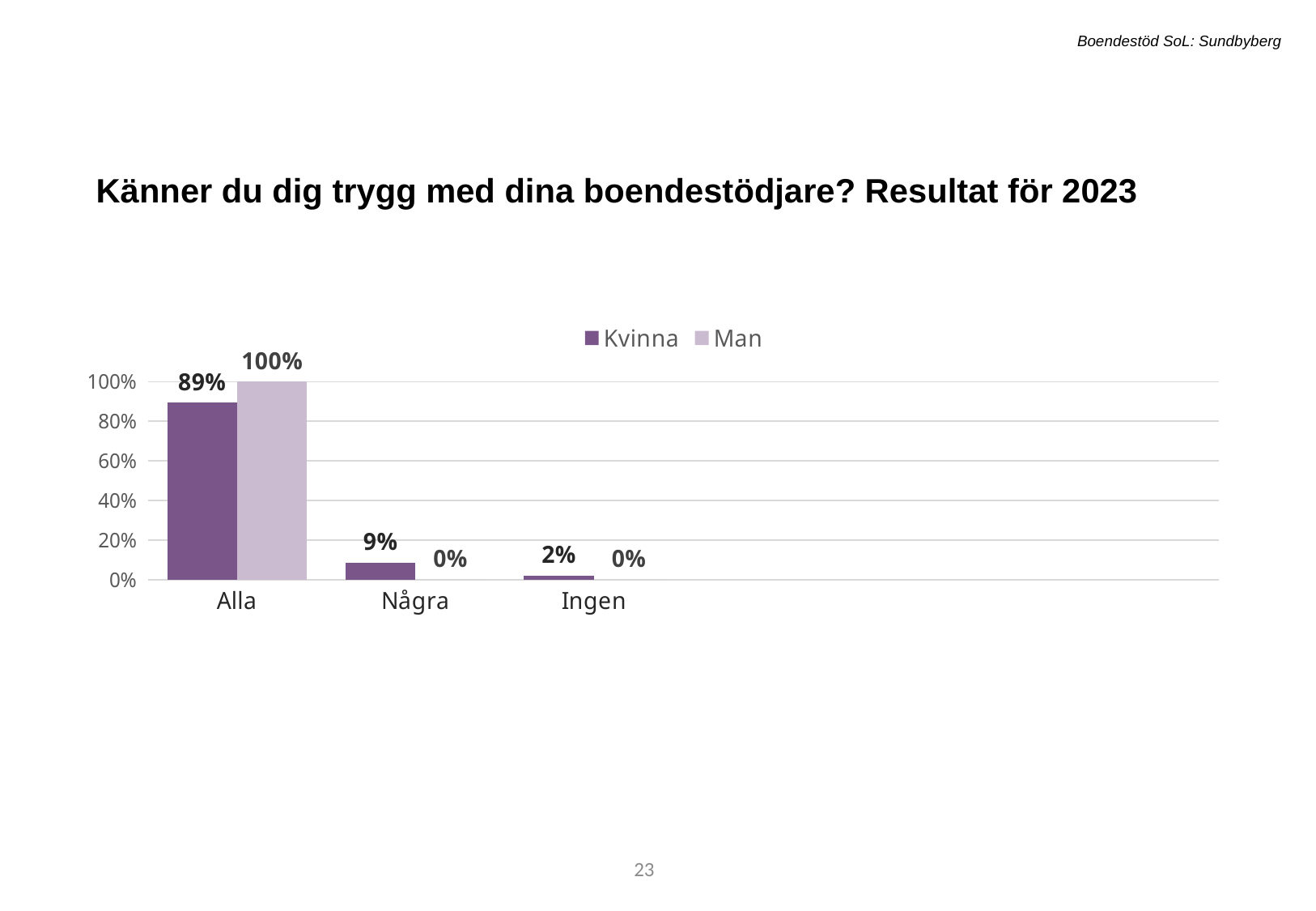
What is the value for Kvinna in the Ingen category? 2% How many series does the legend list? 2 Which is larger in the Några category, Kvinna or Man? Kvinna How many categories are shown on the x axis? 3 Which category has the lowest value for the Kvinna series? Ingen What is the difference between the Man and Kvinna values in the Alla category? 11% Which category has the highest value for the Kvinna series? Alla What is the value for Man in the Alla category? 100% What is the value for Man in the Ingen category? 0% What is the value for Kvinna in the Några category? 9% What is the value for Kvinna in the Alla category? 89% What kind of chart is shown on the slide? Bar chart